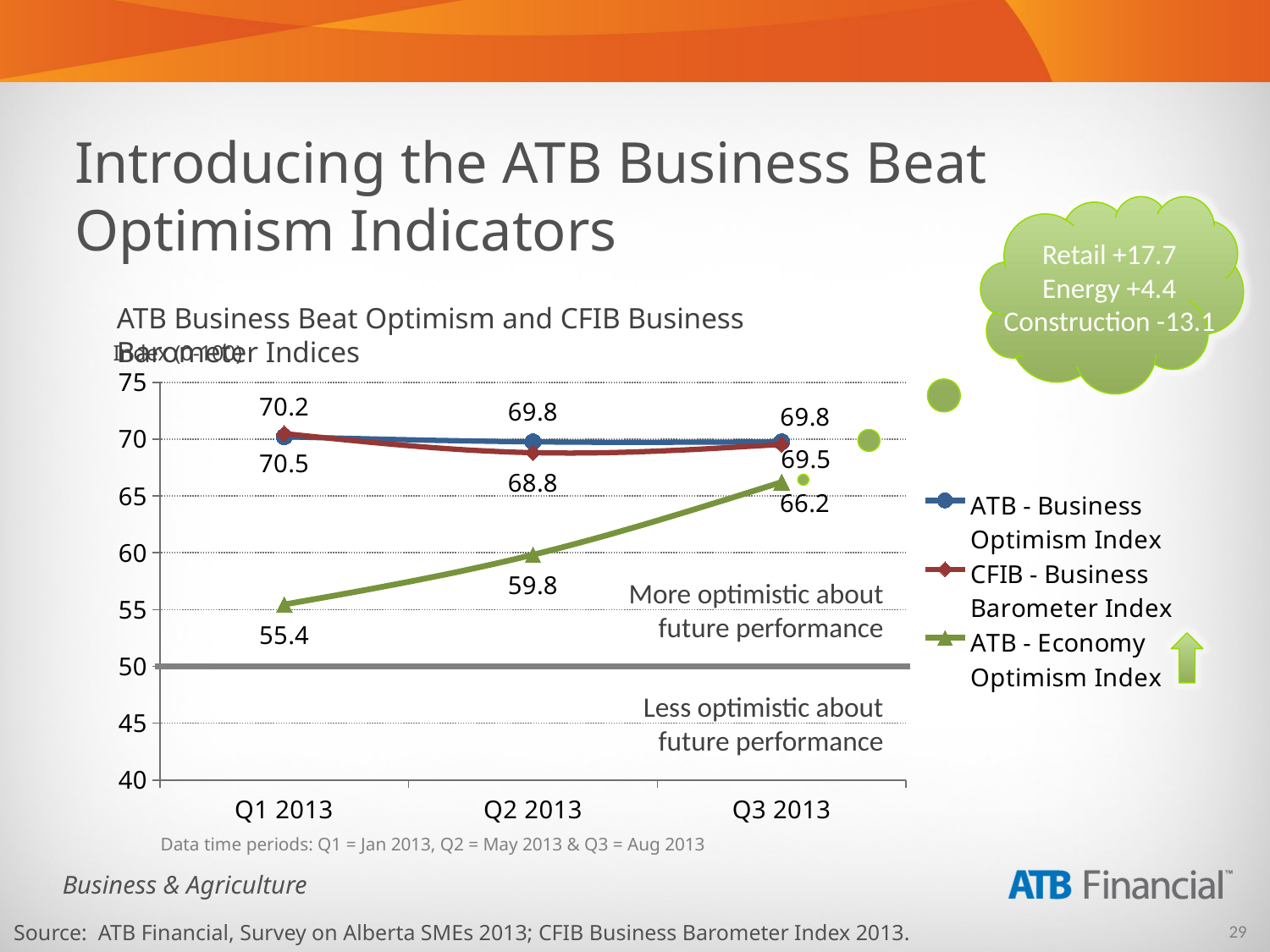
Does the ATB - Economy Optimism Index rise or fall from Q1 2013 to Q3 2013? rise What is the title of the chart? ATB Business Beat Optimism and CFIB Business Barometer Indices In which quarter is the ATB - Economy Optimism Index lowest? Q1 2013 What is the value of the ATB - Business Optimism Index in Q1 2013? 70.2 What is the difference between the ATB - Economy Optimism Index in Q3 2013 and Q1 2013? 10.8 What type of chart is shown on the slide? line chart Which is larger in Q2 2013: the ATB - Business Optimism Index or the ATB - Economy Optimism Index? ATB - Business Optimism Index How many series does the legend list? 3 What is the value of the ATB - Economy Optimism Index in Q3 2013? 66.2 What is the value of the CFIB - Business Barometer Index in Q2 2013? 68.8 How many time periods are shown on the x axis? 3 What is the value of the ATB - Economy Optimism Index in Q1 2013? 55.4